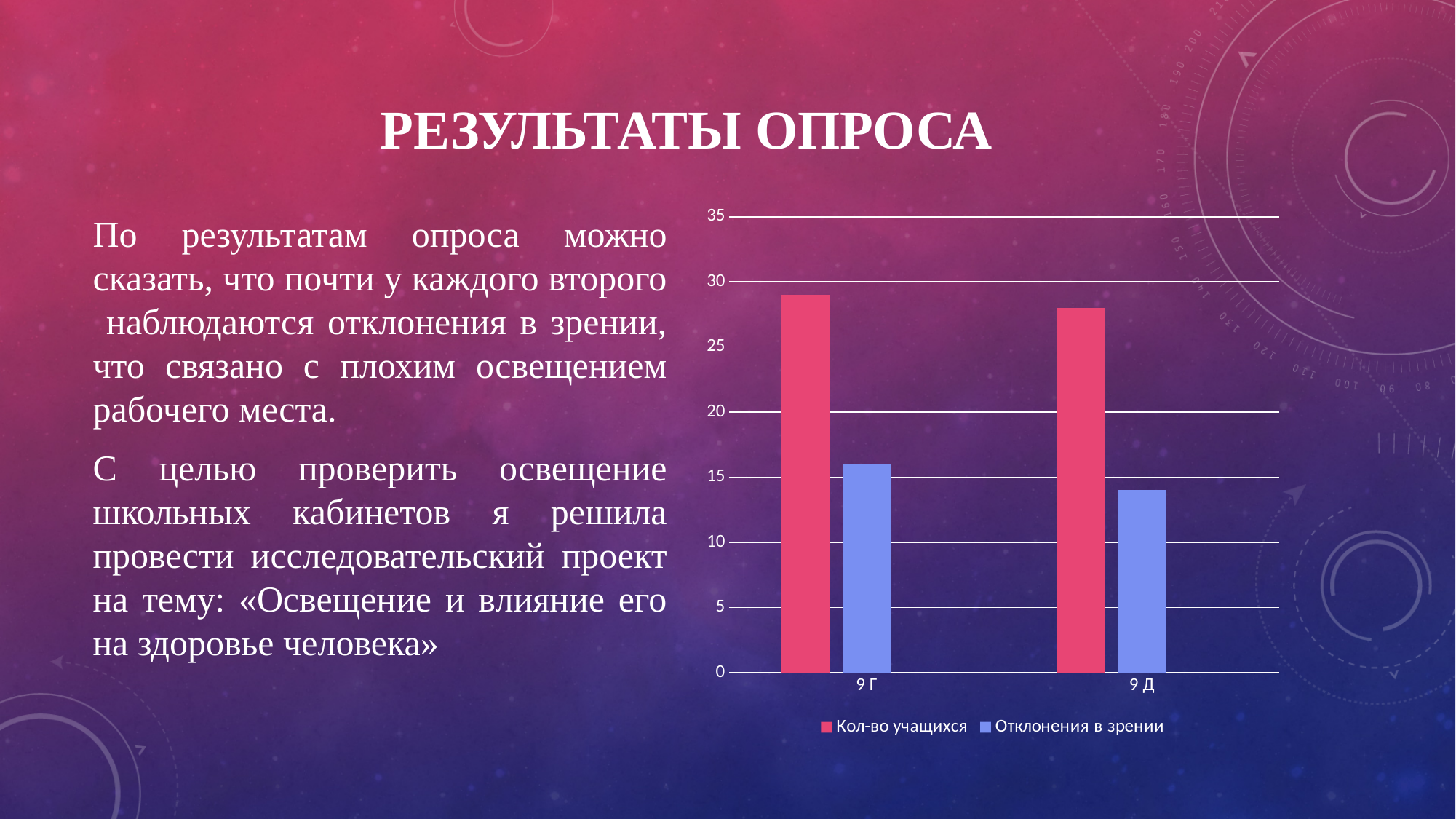
Which series is shown in pink/red in the chart? Кол-во учащихся For 9 Д, which is larger: Кол-во учащихся or Отклонения в зрении? Кол-во учащихся How many categories are shown on the x axis of the chart? 2 Is the value of Отклонения в зрении for 9 Д greater or less than 10? greater Is the value of Кол-во учащихся for 9 Д greater or less than 30? less Is the value of Отклонения в зрении for 9 Г greater or less than 20? less Which category has the lowest value of Отклонения в зрении? 9 Д How many series does the chart's legend list? 2 For 9 Г, which is larger: Кол-во учащихся or Отклонения в зрении? Кол-во учащихся Which series is shown in blue in the chart? Отклонения в зрении What kind of chart is shown on the slide? bar chart